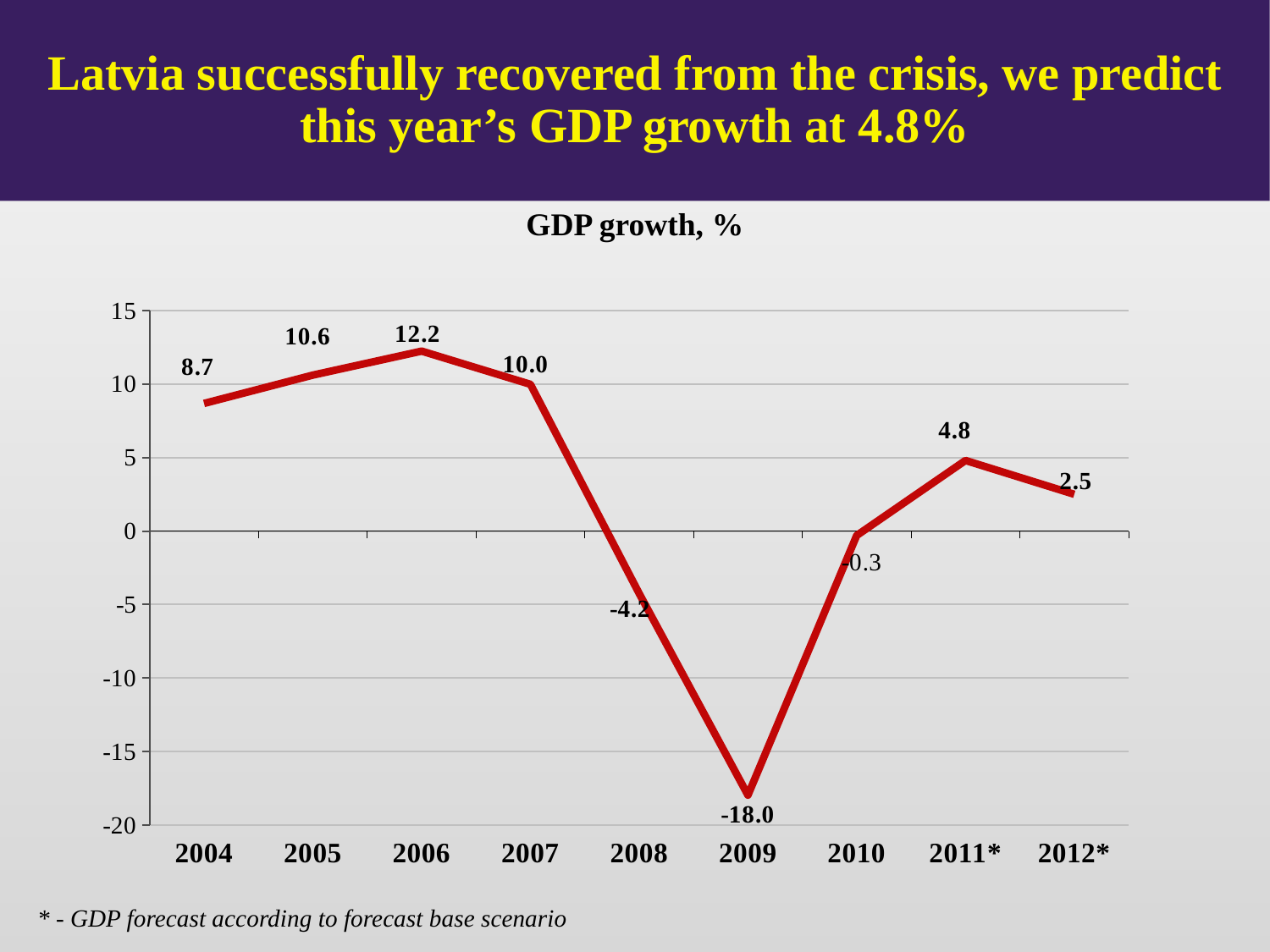
Does GDP growth rise or fall from 2007 to 2009? fall What is the title of the chart? GDP growth, % Which year has the lowest GDP growth? 2009 What is the GDP growth value for 2011*? 4.8 Which year has a higher GDP growth value, 2005 or 2012*? 2005 What is the GDP growth value for 2006? 12.2 What is the GDP growth value for 2009? -18.0 Is the GDP growth value for 2008 greater or less than 0? less What is the difference between the GDP growth values for 2006 and 2007? 2.2 How many years are plotted on the chart? 9 Which year has the highest GDP growth? 2006 What kind of chart is shown on the slide? line chart